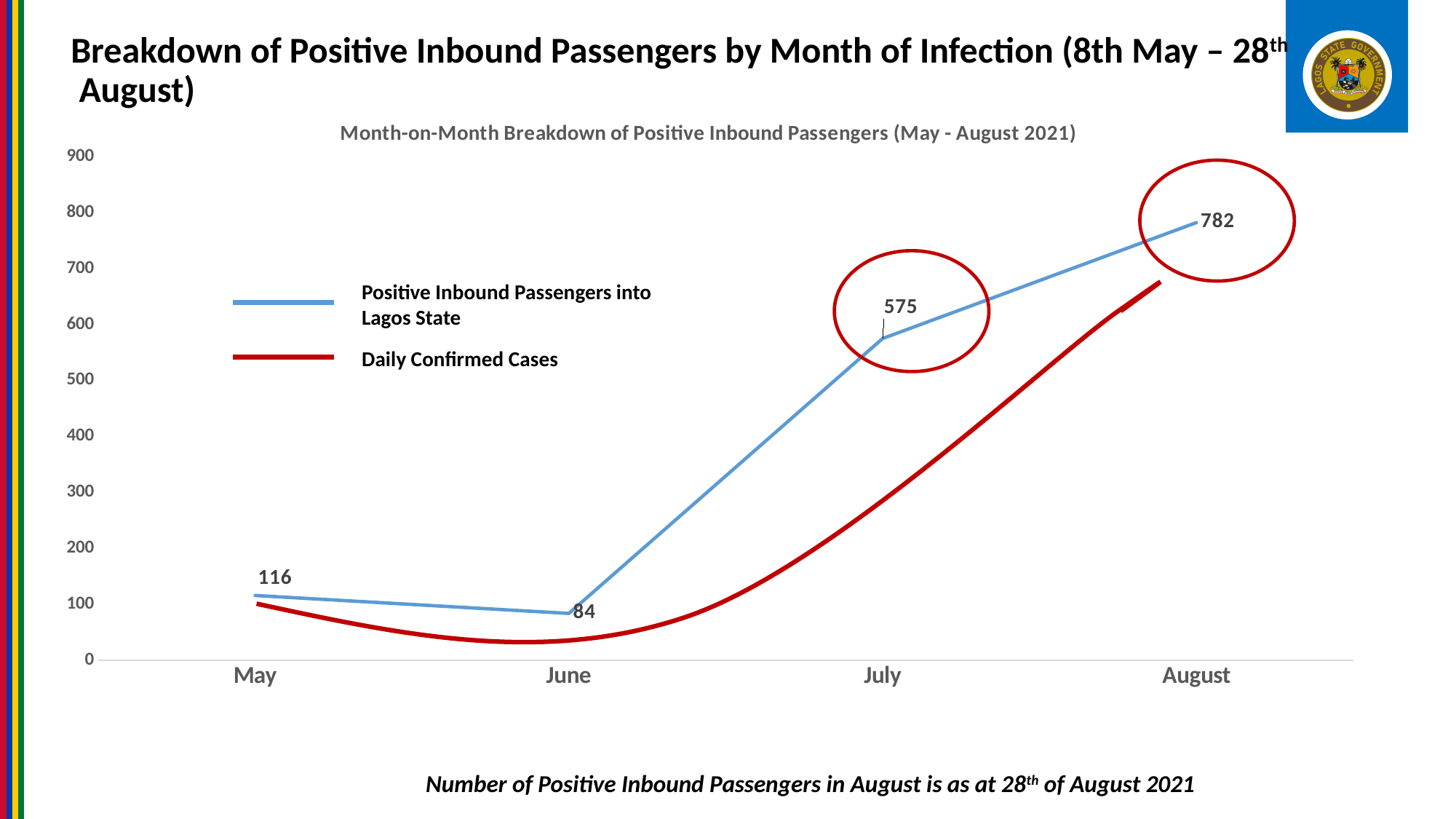
What is the value for Positive Inbound Passengers into Lagos State in June? 84 What kind of chart is shown on the slide? Line chart How many series does the legend list? 2 What is the value for Positive Inbound Passengers into Lagos State in July? 575 Which month has the lowest number of Positive Inbound Passengers into Lagos State? June Which month has the highest number of Positive Inbound Passengers into Lagos State? August What is the value for Positive Inbound Passengers into Lagos State in May? 116 How many months are shown on the x axis? 4 What is the value for Positive Inbound Passengers into Lagos State in August? 782 Is the value for Daily Confirmed Cases in August greater or less than 600? greater What is the difference between the Positive Inbound Passengers values for August and July? 207 Which is larger, the Positive Inbound Passengers value for May or for June? May